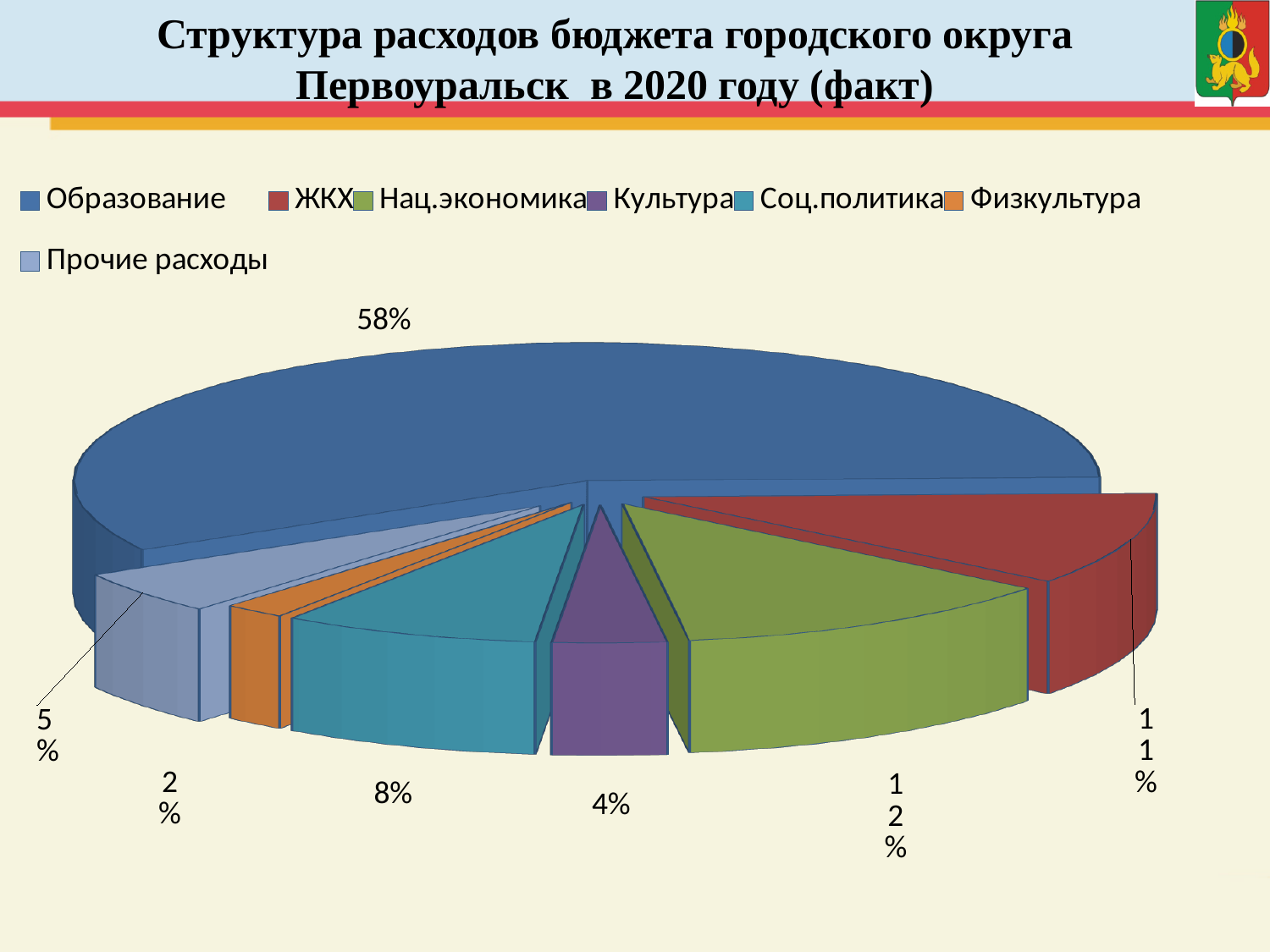
Which category has the largest share of the budget expenditure? Образование What is the difference in percentage points between the shares of Образование and Нац.экономика? 46 How many categories does the legend list? 7 What share of the budget expenditure goes to ЖКХ? 11% What share of the budget expenditure goes to Культура? 4% What share of the budget expenditure goes to Образование? 58% What share of the budget expenditure goes to Нац.экономика? 12% What share of the budget expenditure goes to Физкультура? 2% What share of the budget expenditure goes to Соц.политика? 8% What type of chart is shown on the slide? pie chart Which has a larger share, Соц.политика or Прочие расходы? Соц.политика Which category has the smallest share of the budget expenditure? Физкультура